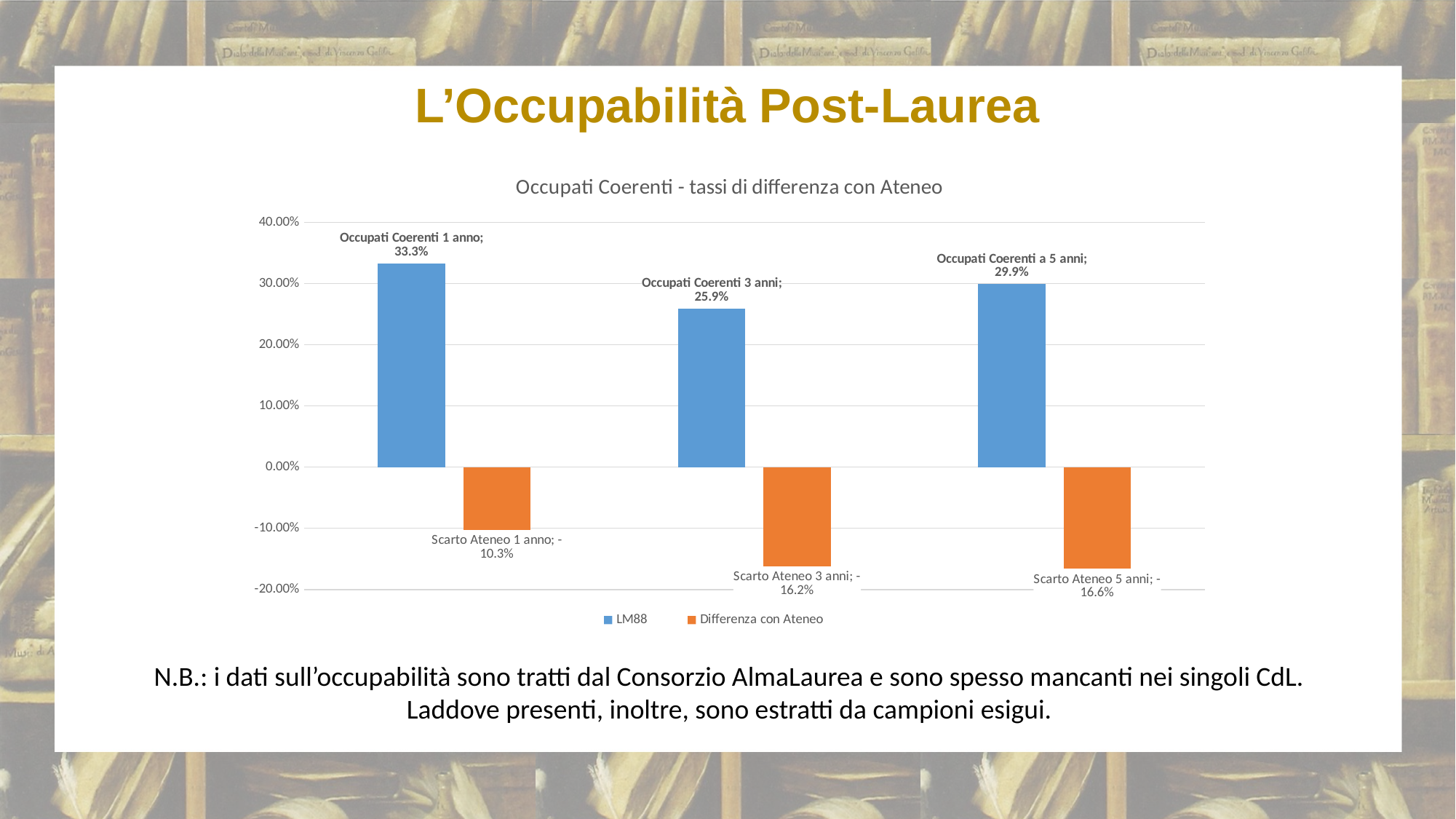
What type of chart is shown on the slide? bar chart What is the difference between the LM88 value at 1 anno (33.3%) and at 3 anni (25.9%)? 7.4% How many series does the chart legend list? 2 Which series is shown in orange in the legend? Differenza con Ateneo What is the LM88 value labelled 'Occupati Coerenti 1 anno'? 33.3% What is the value labelled 'Scarto Ateneo 3 anni'? -16.2% Which of the three LM88 bars (1 anno, 3 anni, 5 anni) has the highest value? 1 anno Which of the three LM88 bars (1 anno, 3 anni, 5 anni) has the lowest value? 3 anni What is the value labelled 'Scarto Ateneo 5 anni'? -16.6% What is the LM88 value labelled 'Occupati Coerenti a 5 anni'? 29.9% What is the title of the chart? Occupati Coerenti - tassi di differenza con Ateneo What is the LM88 value labelled 'Occupati Coerenti 3 anni'? 25.9%